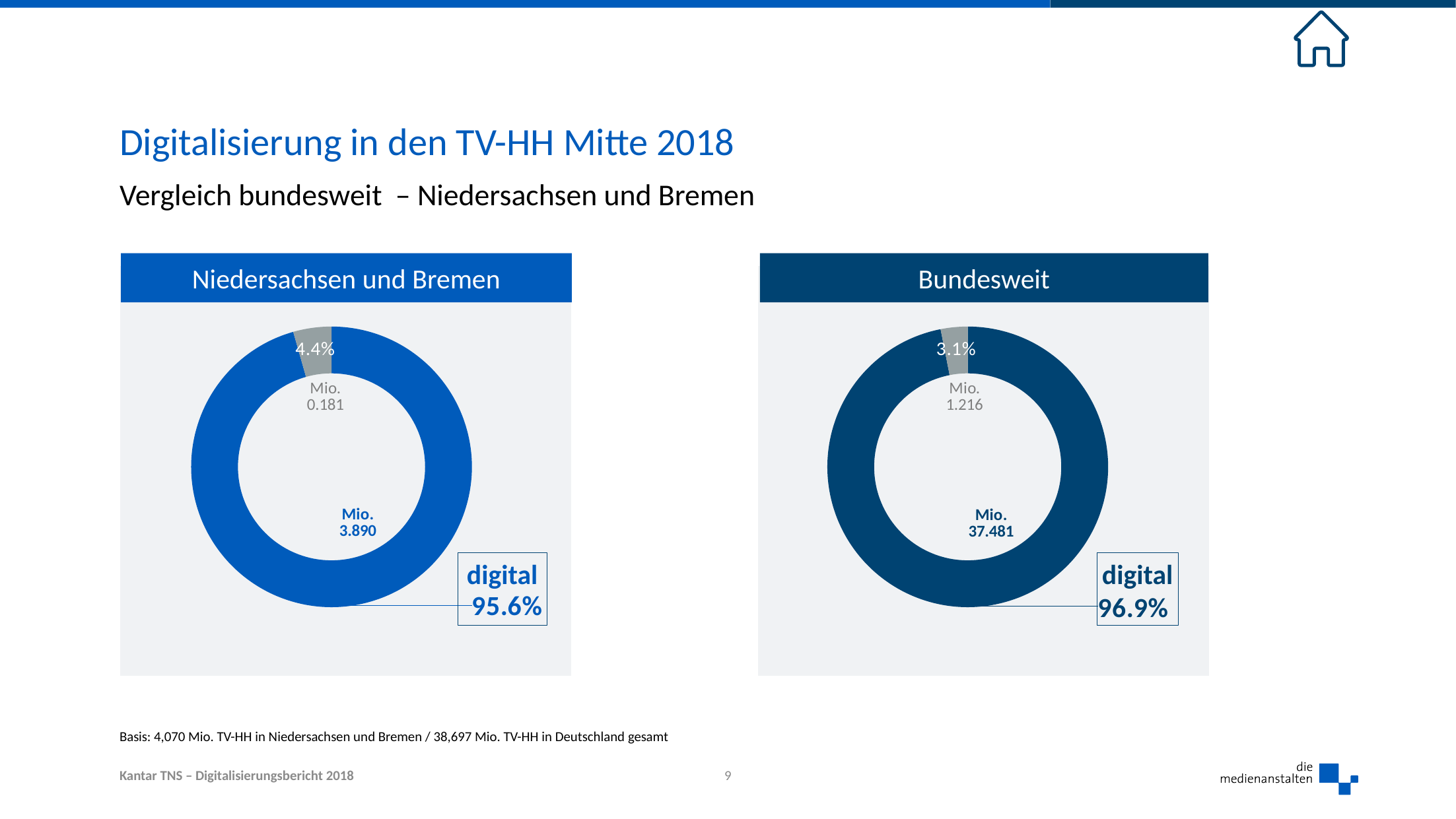
How many slices does the 'Bundesweit' chart have? 2 What is the difference in percentage points between the digital share in the 'Bundesweit' chart and the 'Niedersachsen und Bremen' chart? 1.3 percentage points In the 'Niedersachsen und Bremen' chart, how many million households are digital? 3.890 Mio. What kind of chart is used in the 'Niedersachsen und Bremen' panel? Donut (pie) chart In the 'Niedersachsen und Bremen' chart, what percentage does the grey slice represent? 4.4% In the 'Bundesweit' chart, how many million households are digital? 37.481 Mio. In the 'Bundesweit' chart, what percentage does the grey slice represent? 3.1% In the 'Niedersachsen und Bremen' chart, how many million households does the grey slice represent? 0.181 Mio. In the 'Bundesweit' chart, what share of TV households is digital? 96.9% Which chart shows the higher digital share, 'Niedersachsen und Bremen' or 'Bundesweit'? Bundesweit In the 'Bundesweit' chart, how many million households does the grey slice represent? 1.216 Mio. In the 'Niedersachsen und Bremen' chart, what share of TV households is digital? 95.6%